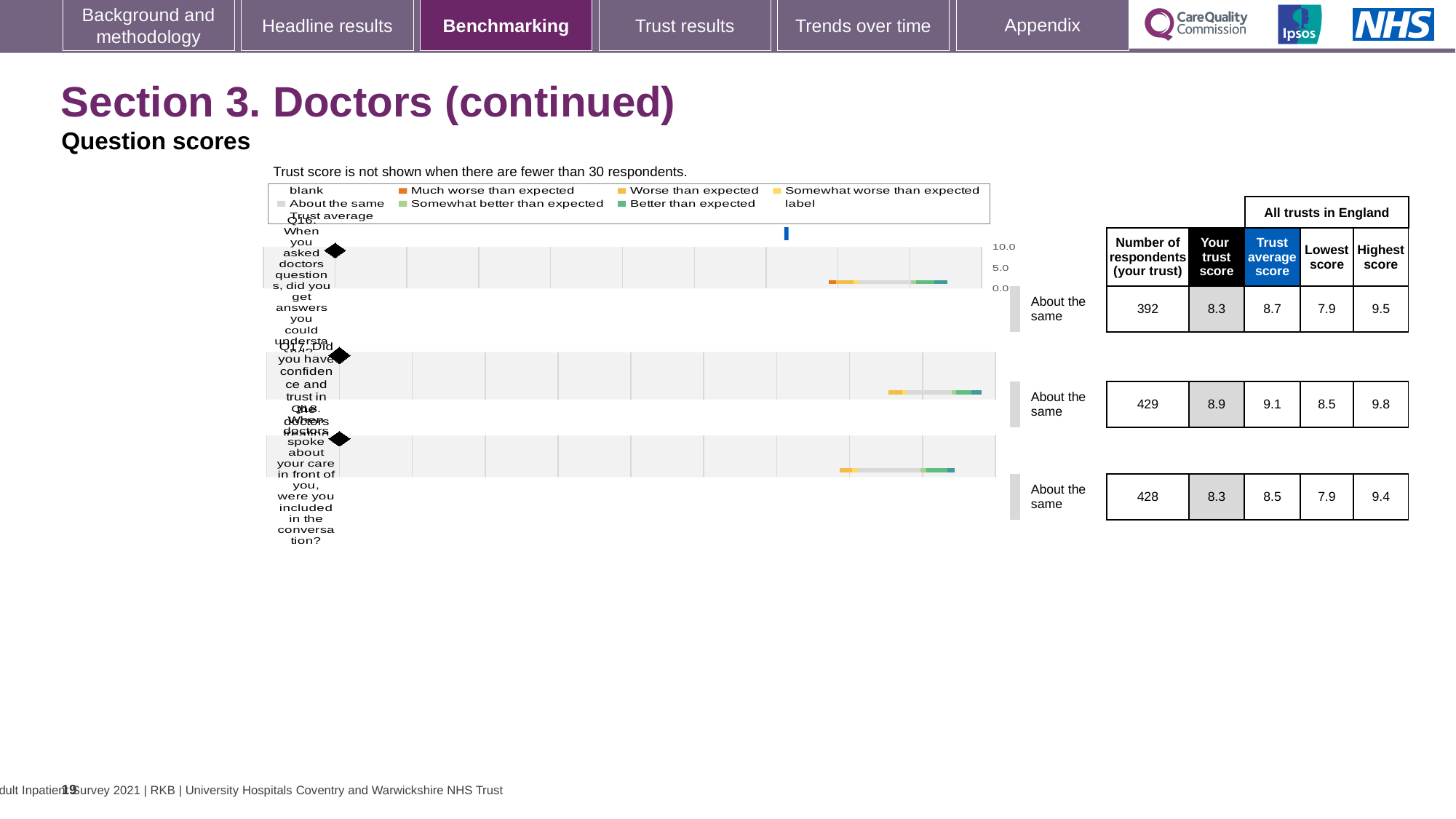
What benchmark category is shown for Q16, Q17 and Q18? About the same What is the trust score for Q16 (When you asked doctors questions, did you get answers you could understand)? 8.3 What is the highest score across all trusts in England for Q17? 9.8 Is the trust score for Q18 greater or less than 5.0? greater For Q16, which is larger: the trust score or the trust average score? Trust average score What kind of chart is used to show the question scores on this slide? bar chart How many questions are plotted in the question scores chart? 3 What is the trust average score for Q18 (When doctors spoke about your care in front of you, were you included in the conversation)? 8.5 How many respondents answered Q17 at this trust? 429 What is the difference between the trust score for Q17 and the trust score for Q16? 0.6 Which question has the highest trust score? Q17 What is the trust score for Q17 (Did you have confidence and trust in the doctors treating you)? 8.9